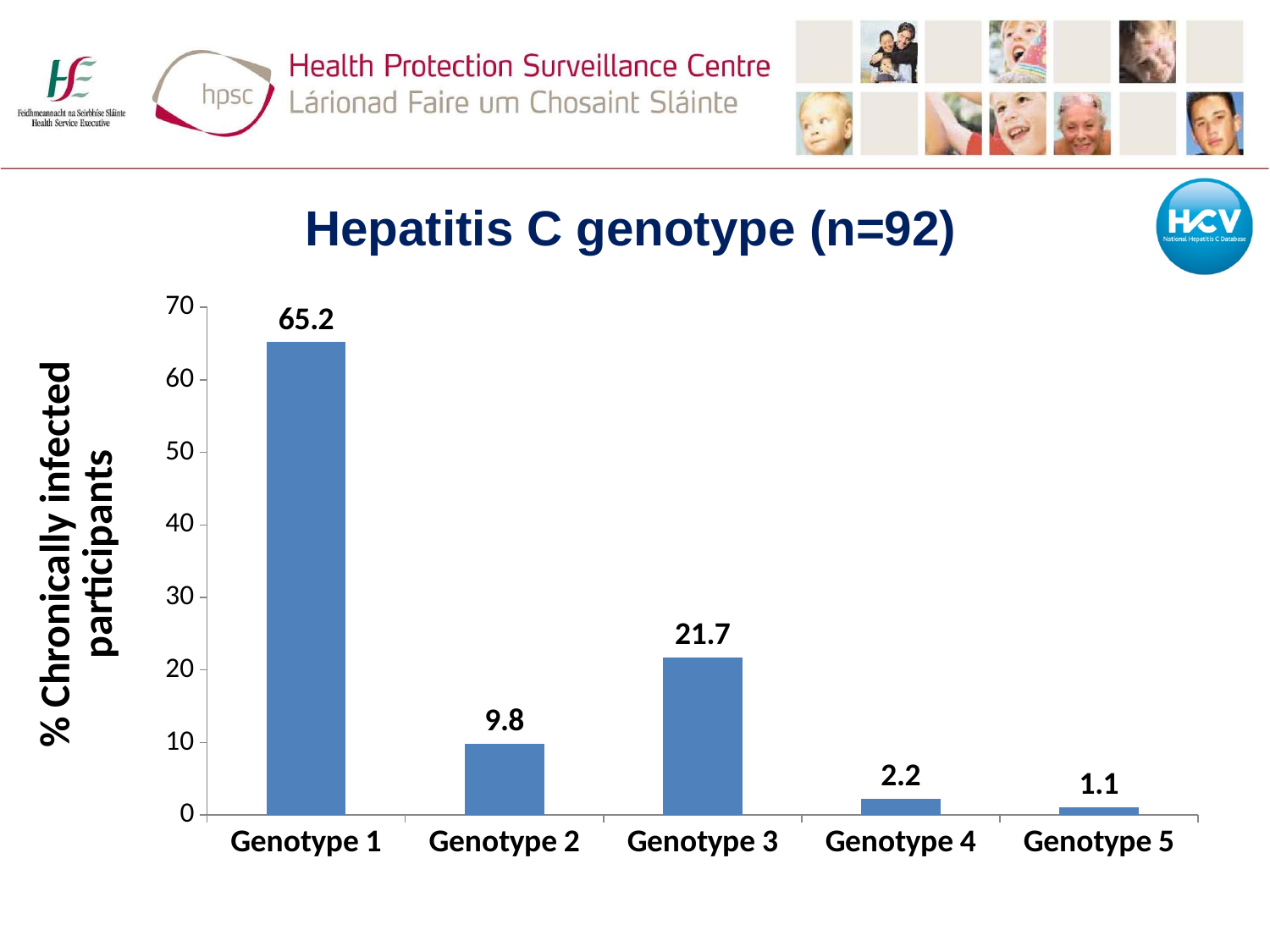
Which genotype has the highest percentage of chronically infected participants? Genotype 1 What is the value for Genotype 5? 1.1 What is the difference between the values for Genotype 1 and Genotype 3? 43.5 What is the value for Genotype 3? 21.7 How many genotype categories are shown on the chart? 5 What is the difference between the values for Genotype 2 and Genotype 4? 7.6 What is the value for Genotype 1? 65.2 Which genotype has the lowest percentage of chronically infected participants? Genotype 5 What is the title of the chart? Hepatitis C genotype (n=92) What kind of chart is shown on the slide? bar chart Which is larger, the value for Genotype 2 or the value for Genotype 3? Genotype 3 Is the value for Genotype 1 greater or less than 60? greater